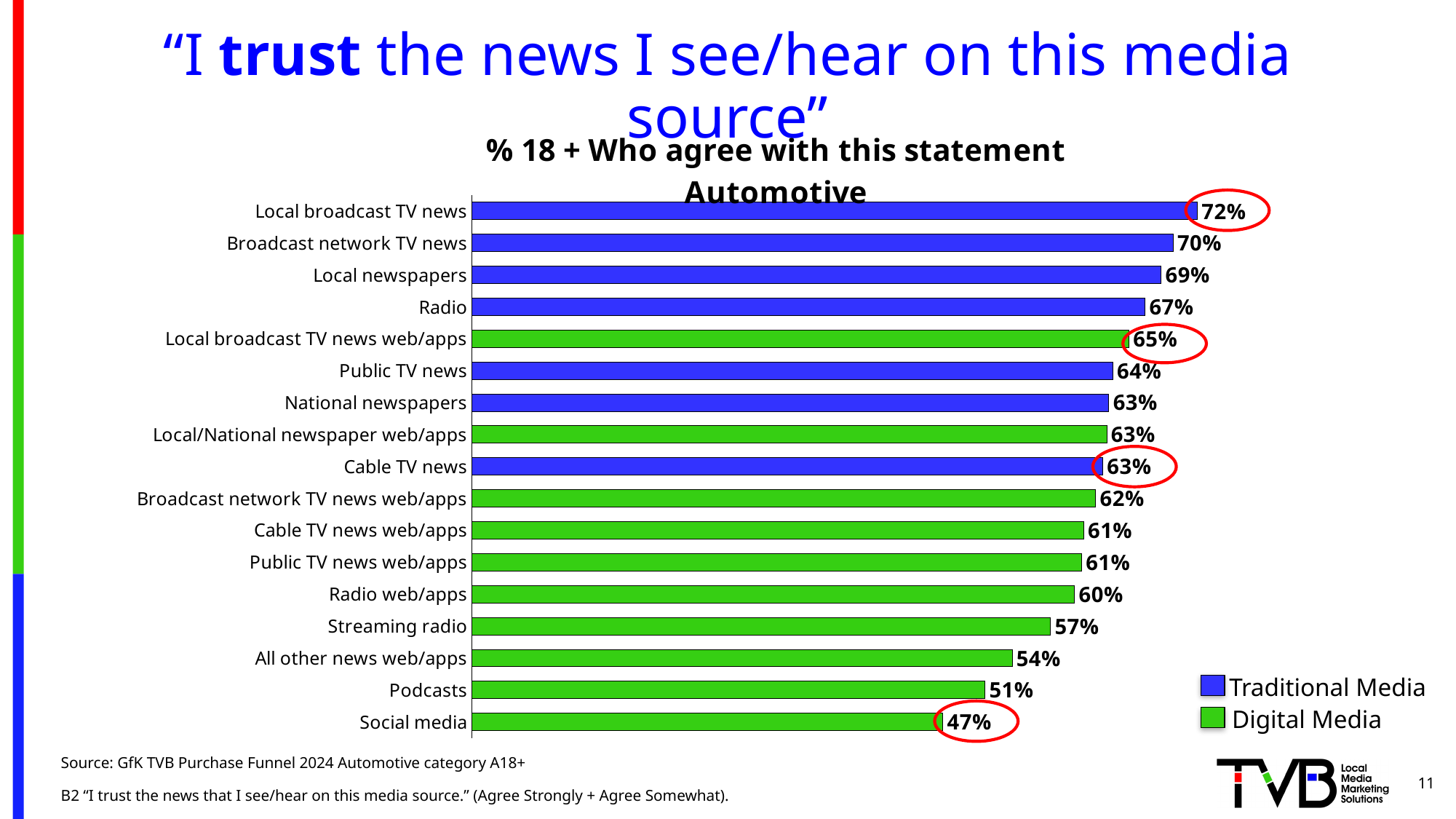
What is the value shown for Streaming radio? 57% Which media source has the lowest percentage of agreement? Social media How many media sources are listed in the chart? 17 Which media source has the highest percentage of agreement? Local broadcast TV news What type of chart is shown on the slide? Bar chart What is the value shown for Local broadcast TV news web/apps? 65% What percentage of adults 18+ agree they trust the news on Local broadcast TV news? 72% Which colour represents Digital Media in the legend? Green Which has a higher value, Radio or Podcasts? Radio How many series does the legend list? 2 What is the value shown for Social media? 47% What is the difference in percentage points between Local broadcast TV news and Social media? 25